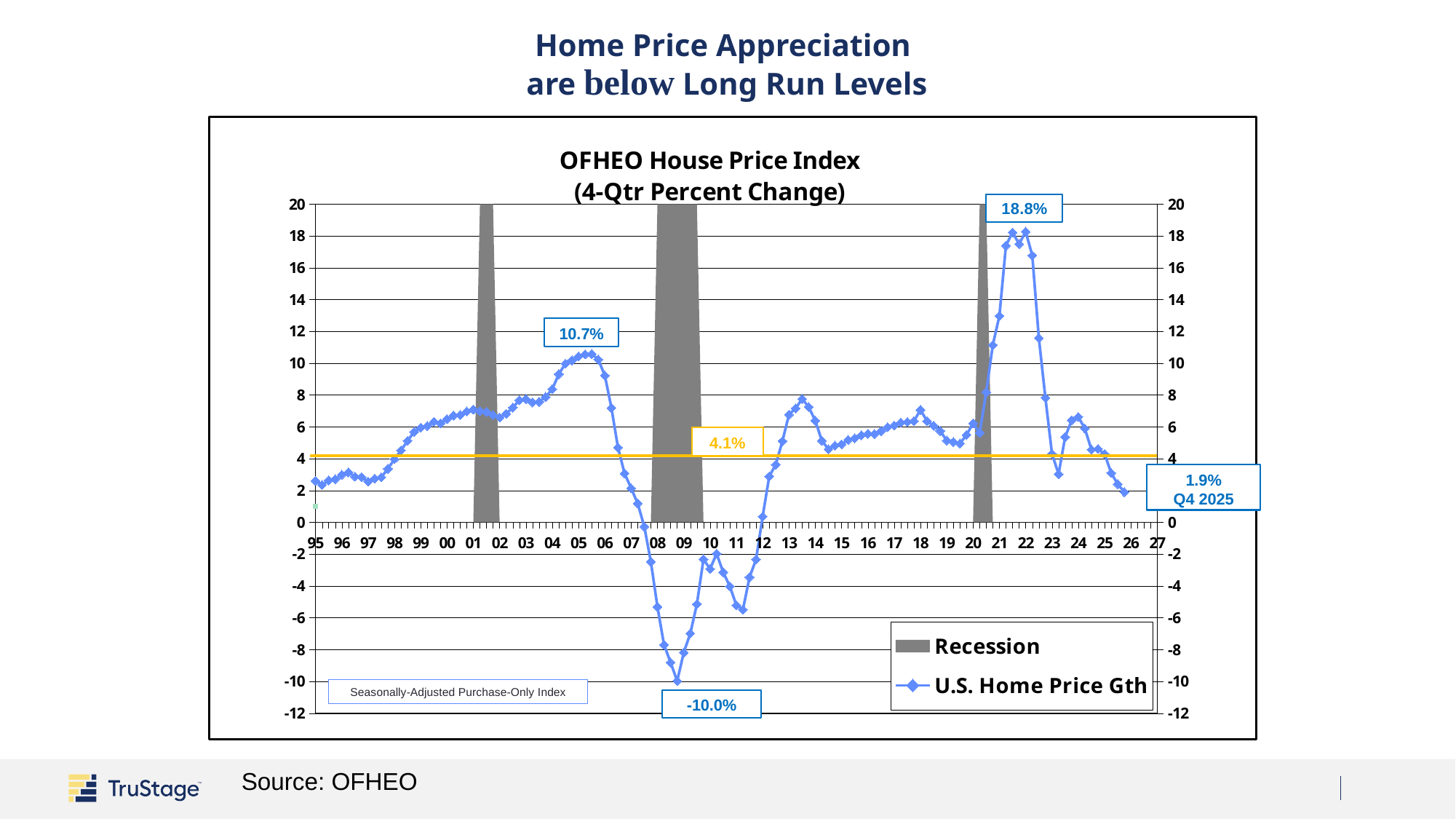
How much lower is the Q4 2025 value (1.9%) than the 4.1% reference line? 2.2% What value is labeled on the horizontal orange reference line? 4.1% What is the labeled lowest value of U.S. Home Price Gth, reached around 2009? -10.0% Is the value of U.S. Home Price Gth at 2022 greater or less than 14? greater What is the labeled peak value of U.S. Home Price Gth reached around 2005? 10.7% What is the labeled peak value of U.S. Home Price Gth reached around 2021-2022? 18.8% What kind of chart is shown on the slide? Line chart How many entries does the legend list? 2 What is the value of U.S. Home Price Gth labeled for Q4 2025? 1.9% What is the title of the chart? OFHEO House Price Index (4-Qtr Percent Change) What is the difference between the 2021-2022 peak (18.8%) and the 2005 peak (10.7%)? 8.1% What is the highest labeled value on the chart? 18.8%